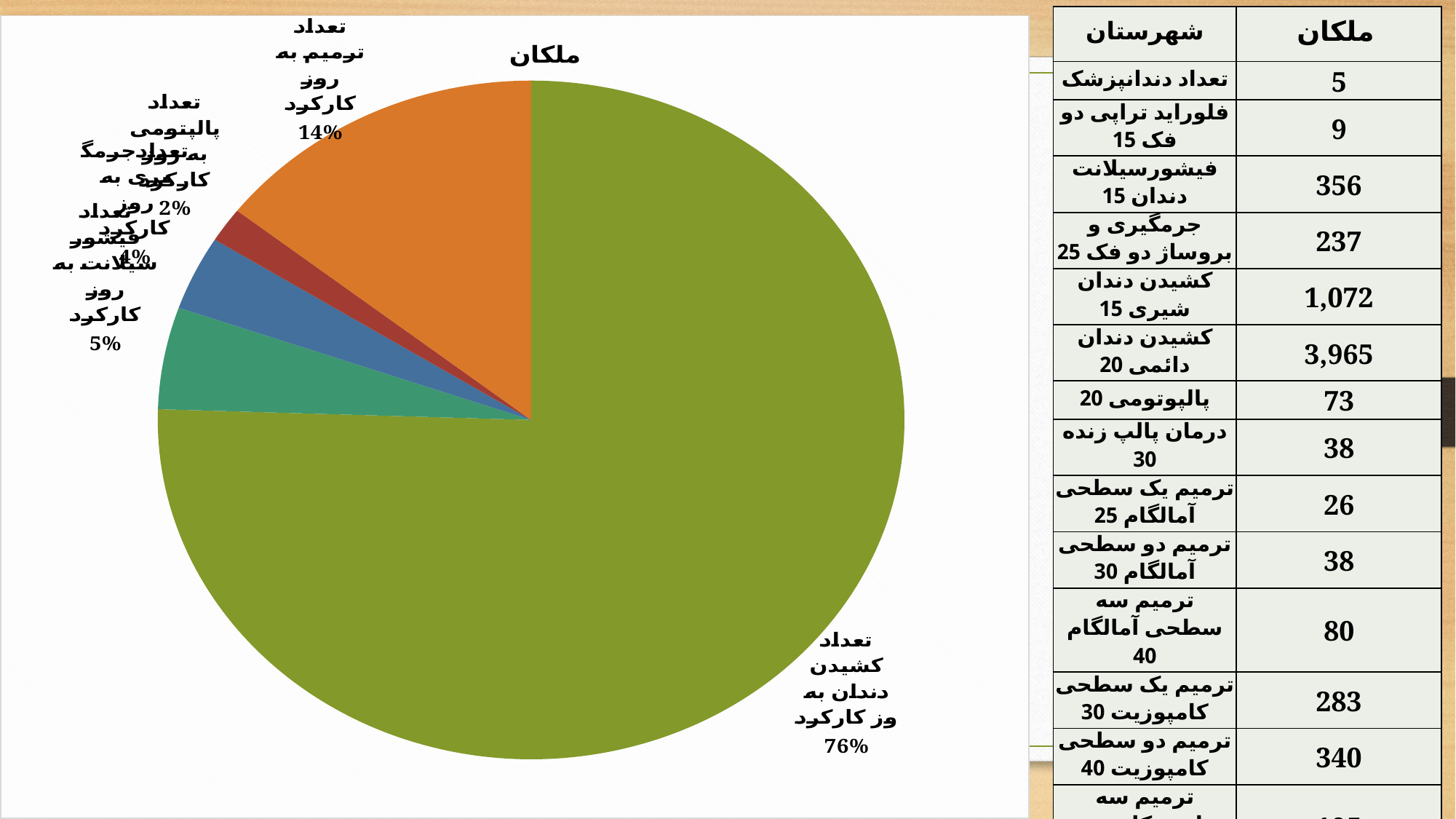
What share of the pie does the slice labelled تعداد فیشورسیلانت به روز کارکرد have? 5% Is the share of the slice labelled تعداد کشیدن دندان به روز کارکرد greater or less than 50%? greater What kind of chart is shown on the slide? pie chart Which slice is the largest in the pie chart? تعداد کشیدن دندان به روز کارکرد What is the smallest percentage shown on the pie chart? 2% What is the difference in percentage points between the largest slice (76%) and the slice labelled تعداد ترمیم به روز کارکرد (14%)? 62 How many slices does the pie chart have? 5 What is the title of the pie chart? ملکان What share of the pie does the slice labelled تعداد ترمیم به روز کارکرد have? 14% What share of the pie does the slice labelled تعداد کشیدن دندان به روز کارکرد have? 76% Which slice is larger: تعداد ترمیم به روز کارکرد or تعداد فیشورسیلانت به روز کارکرد? تعداد ترمیم به روز کارکرد What colour is the largest slice of the pie chart? green